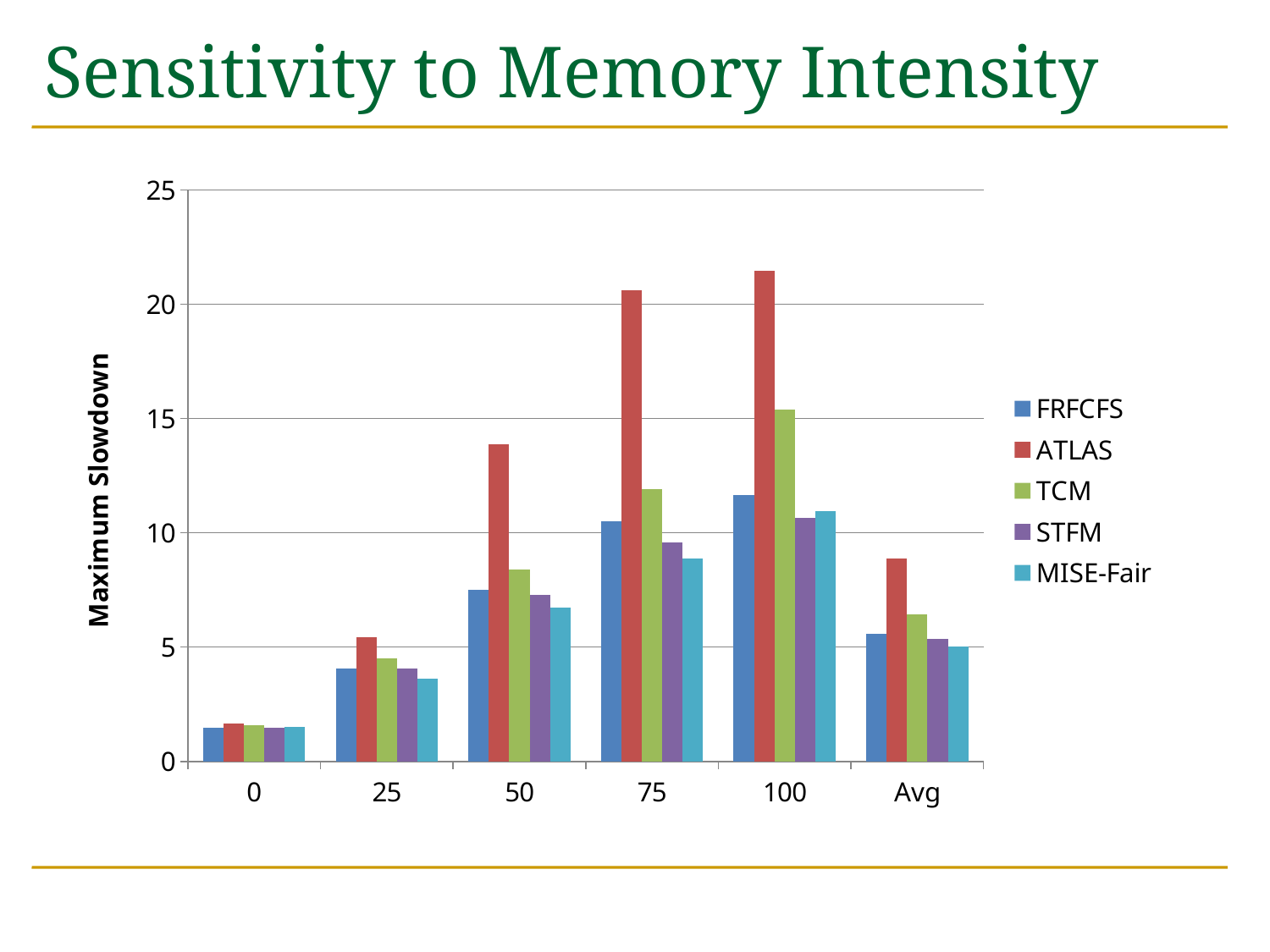
Is the value for ATLAS at 50 greater or less than 10? greater Which series has the highest maximum slowdown at memory intensity 100? ATLAS How many categories are shown along the x axis? 6 What kind of chart is shown on the slide? bar chart Is the value for STFM at 50 greater or less than 10? less What colour represents ATLAS in the legend? red At memory intensity 100, which is larger: TCM or FRFCFS? TCM Which series has the lowest maximum slowdown at memory intensity 75? MISE-Fair How many series does the legend list? 5 Is the value for ATLAS at 75 greater or less than 20? greater What is the label on the y axis? Maximum Slowdown Does the ATLAS series rise or fall as memory intensity goes from 0 to 100? rise